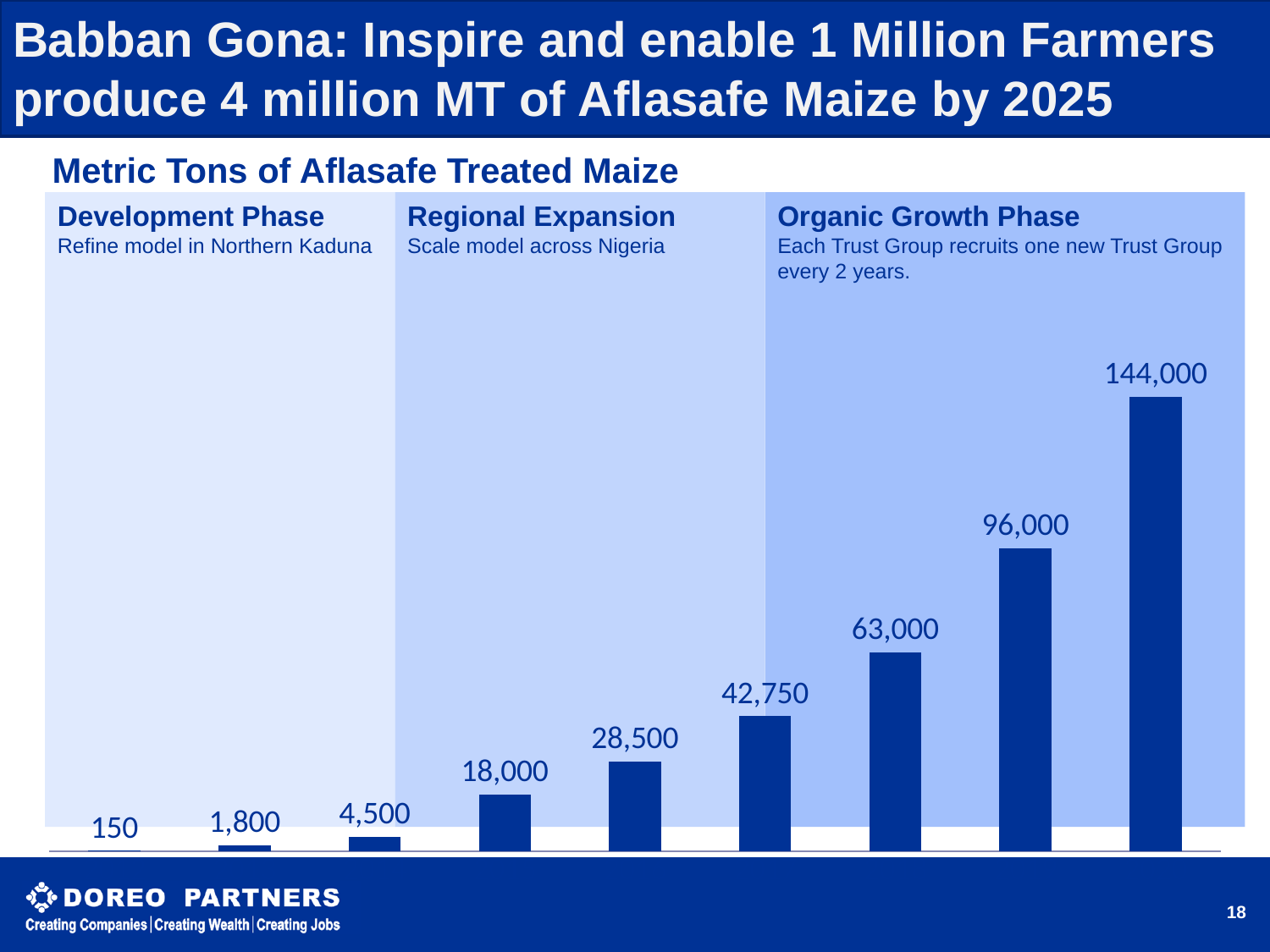
What type of chart is shown on the slide? bar chart How many bars are plotted in the chart? 9 Which is larger, the bar labelled 63,000 or the bar labelled 42,750? 63,000 What is the value of the first (leftmost) bar? 150 What is the value of the shortest bar in the chart? 150 What is the value of the fourth bar from the left? 18,000 What is the title of the chart? Metric Tons of Aflasafe Treated Maize What is the value of the tallest bar in the chart? 144,000 What is the difference between the last bar (144,000) and the second-to-last bar (96,000)? 48,000 What is the difference between the bar labelled 28,500 and the bar labelled 18,000? 10,500 Do the bar values rise or fall from left to right across the chart? rise What is the value of the sixth bar from the left? 42,750